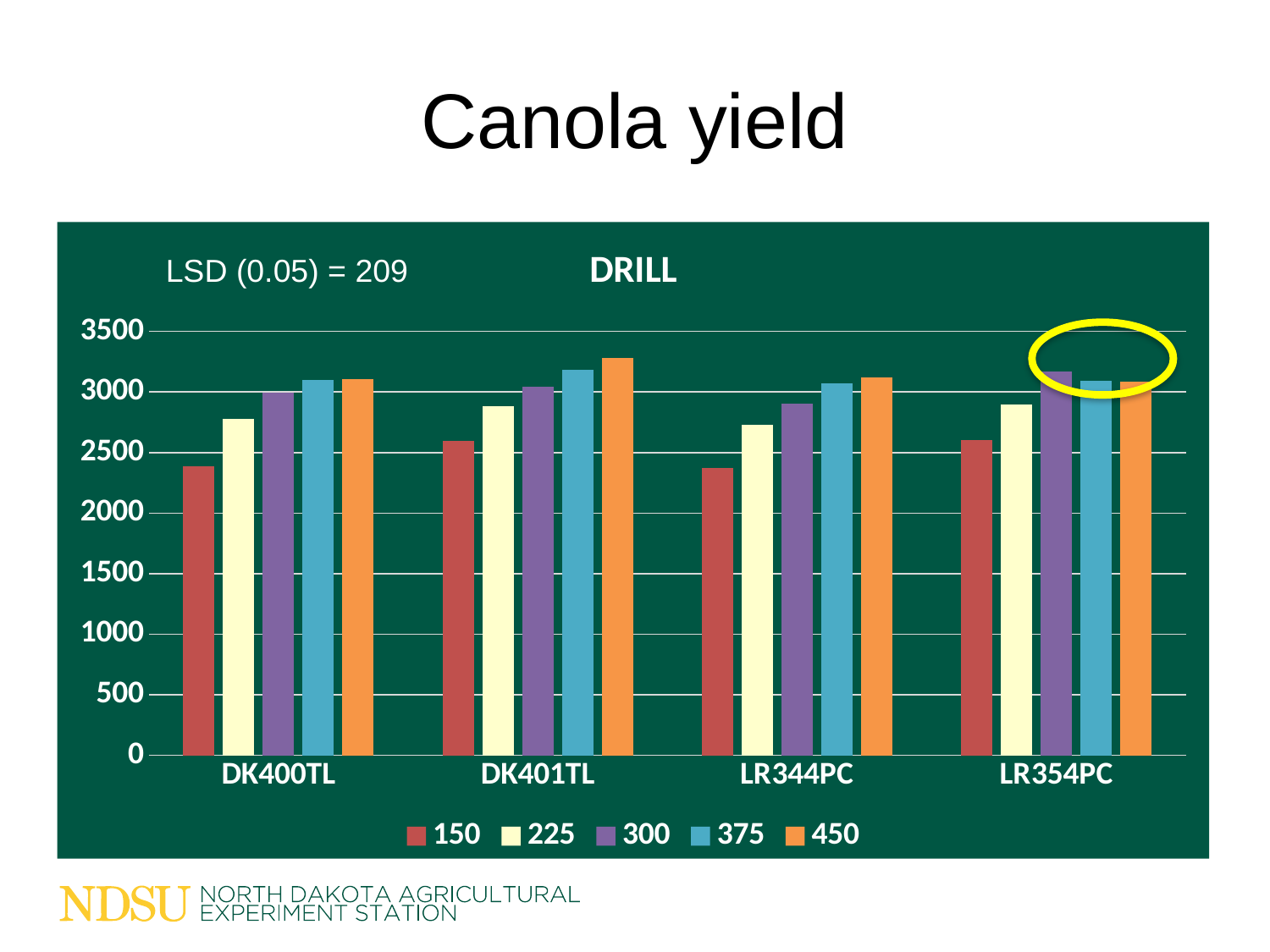
Is the value for the 150 series at DK400TL greater or less than 2500? less How many series does the legend list? 5 Within the DK401TL group, which series has the highest bar? 450 What kind of chart is shown on the slide? bar chart What is the title printed above the chart? DRILL At DK400TL, which is larger: the 150 series or the 225 series? 225 Within the DK400TL group, which series has the lowest bar? 150 What LSD (0.05) value is printed on the chart? 209 Is the value for the 225 series at LR354PC greater or less than 3000? less How many canola varieties (categories) are shown on the x axis? 4 Is the value for the 450 series at DK401TL greater or less than 3000? greater